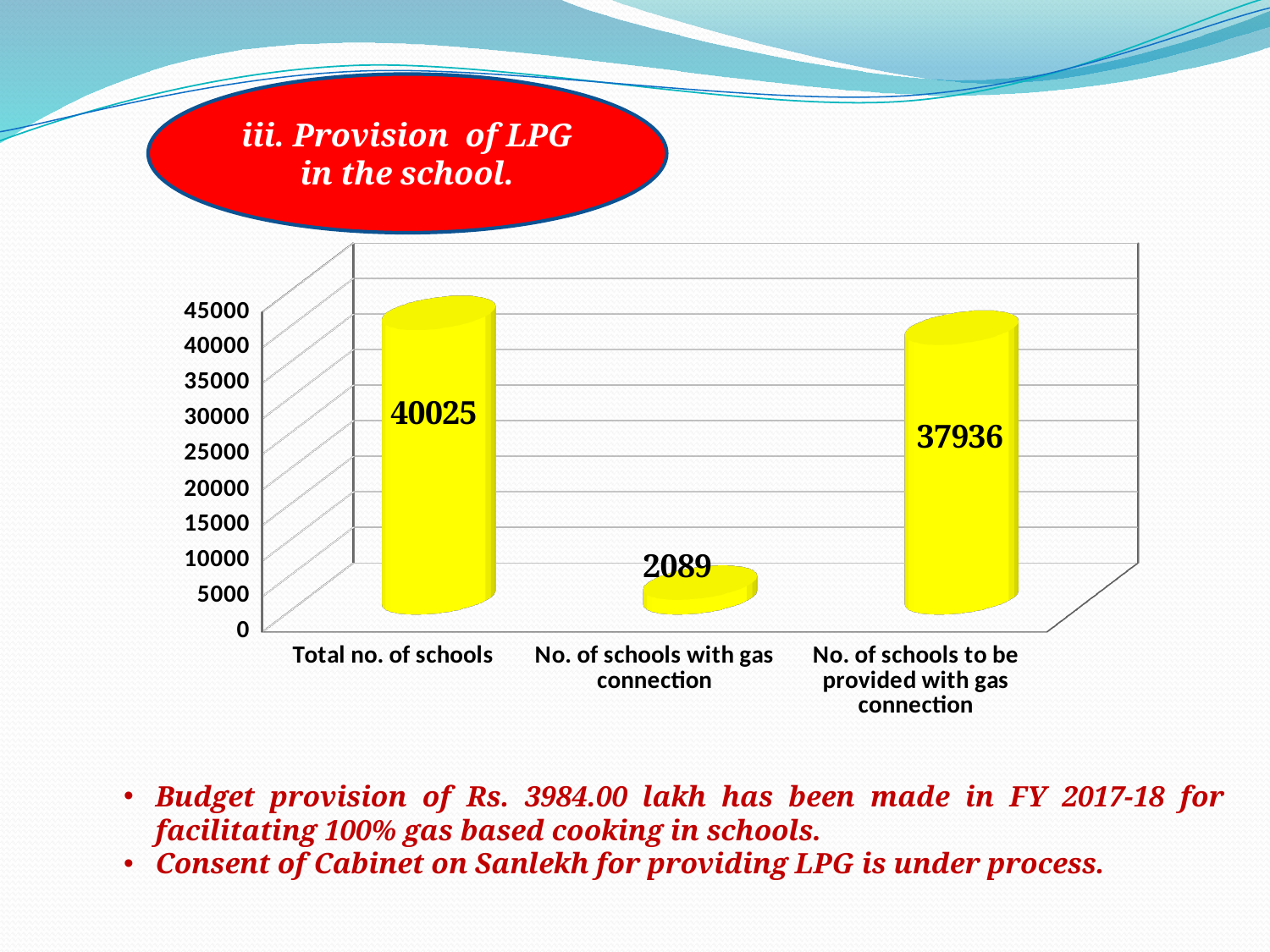
Is the value for No. of schools with gas connection greater or less than 5000? less How many categories are shown on the chart? 3 Which is larger: No. of schools with gas connection or No. of schools to be provided with gas connection? No. of schools to be provided with gas connection Which category has the lowest value? No. of schools with gas connection What is the value for No. of schools to be provided with gas connection? 37936 What colour are the bars in the chart? yellow What is the difference between Total no. of schools and No. of schools to be provided with gas connection? 2089 What kind of chart is shown on the slide? bar chart What is the difference between No. of schools to be provided with gas connection and No. of schools with gas connection? 35847 What is the value for Total no. of schools? 40025 What is the value for No. of schools with gas connection? 2089 Which category has the highest value? Total no. of schools